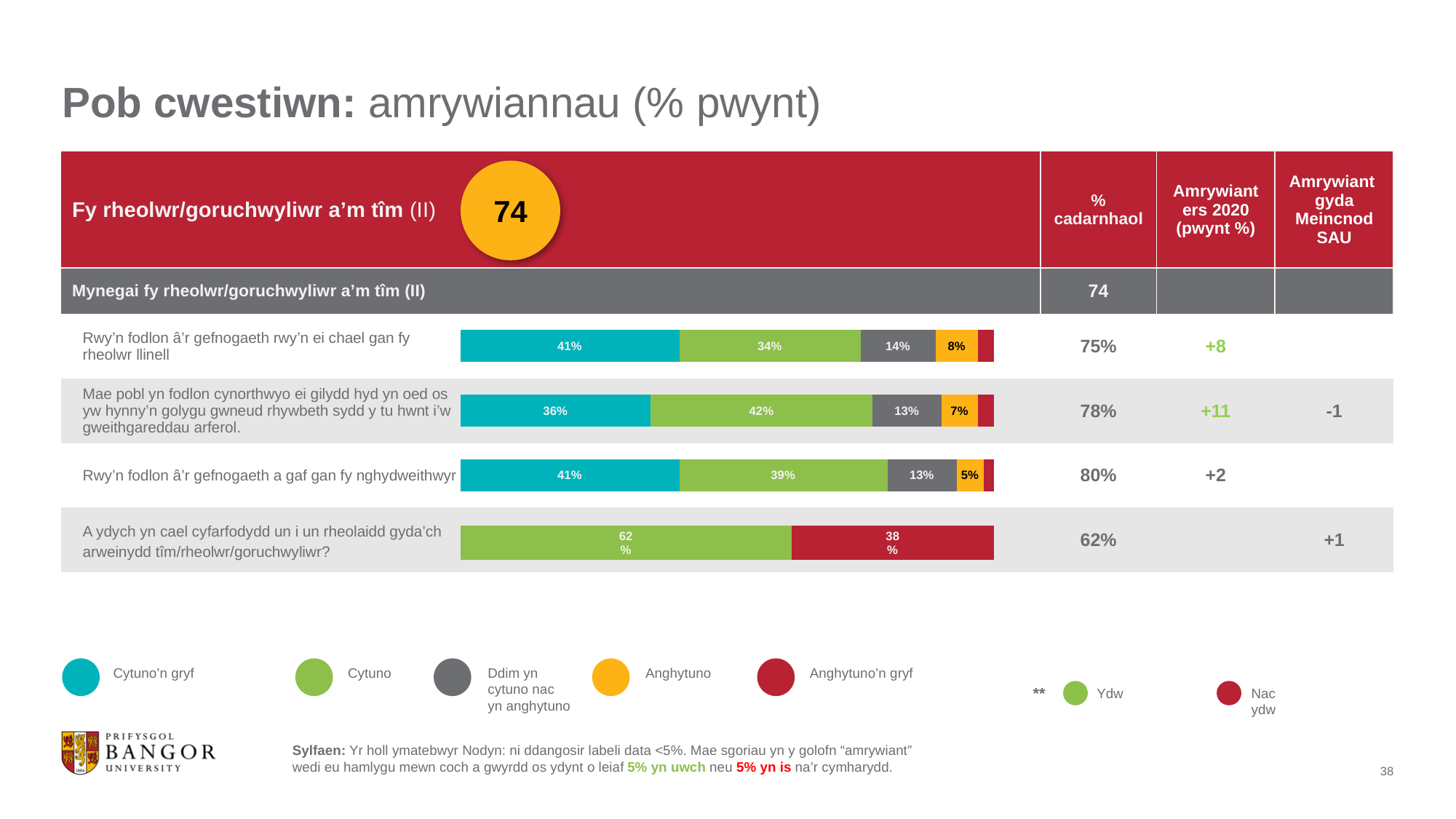
How many response categories does the main legend list (excluding the Ydw/Nac ydw legend)? 5 What is the 'Ydw' value for 'A ydych yn cael cyfarfodydd un i un rheolaidd gyda'ch arweinydd tîm/rheolwr/goruchwyliwr?'? 62% What kind of chart is used to show the responses for each question on this slide? Stacked bar chart What is the 'Cytuno' value for 'Mae pobl yn fodlon cynorthwyo ei gilydd hyd yn oed os yw hynny'n golygu gwneud rhywbeth sydd y tu hwnt i'w gweithgareddau arferol'? 42% What is the 'Anghytuno' value for 'Rwy'n fodlon â'r gefnogaeth a gaf gan fy nghydweithwyr'? 5% For 'Rwy'n fodlon â'r gefnogaeth rwy'n ei chael gan fy rheolwr llinell', what is the difference between the 'Cytuno'n gryf' and 'Cytuno' values? 7 percentage points Is the 'Ddim yn cytuno nac yn anghytuno' value larger for 'Rwy'n fodlon â'r gefnogaeth rwy'n ei chael gan fy rheolwr llinell' or for 'Rwy'n fodlon â'r gefnogaeth a gaf gan fy nghydweithwyr'? Rwy'n fodlon â'r gefnogaeth rwy'n ei chael gan fy rheolwr llinell Which question has the highest 'Cytuno' (green) value among the three agree/disagree bars? Mae pobl yn fodlon cynorthwyo ei gilydd hyd yn oed os yw hynny'n golygu gwneud rhywbeth sydd y tu hwnt i'w gweithgareddau arferol. Which question has the lowest 'Cytuno'n gryf' value among the three agree/disagree bars? Mae pobl yn fodlon cynorthwyo ei gilydd hyd yn oed os yw hynny'n golygu gwneud rhywbeth sydd y tu hwnt i'w gweithgareddau arferol. What colour represents 'Anghytuno'n gryf' in the legend? Red How many questions (bars) are plotted on the slide? 4 What is the 'Cytuno'n gryf' value for 'Rwy'n fodlon â'r gefnogaeth rwy'n ei chael gan fy rheolwr llinell'? 41%